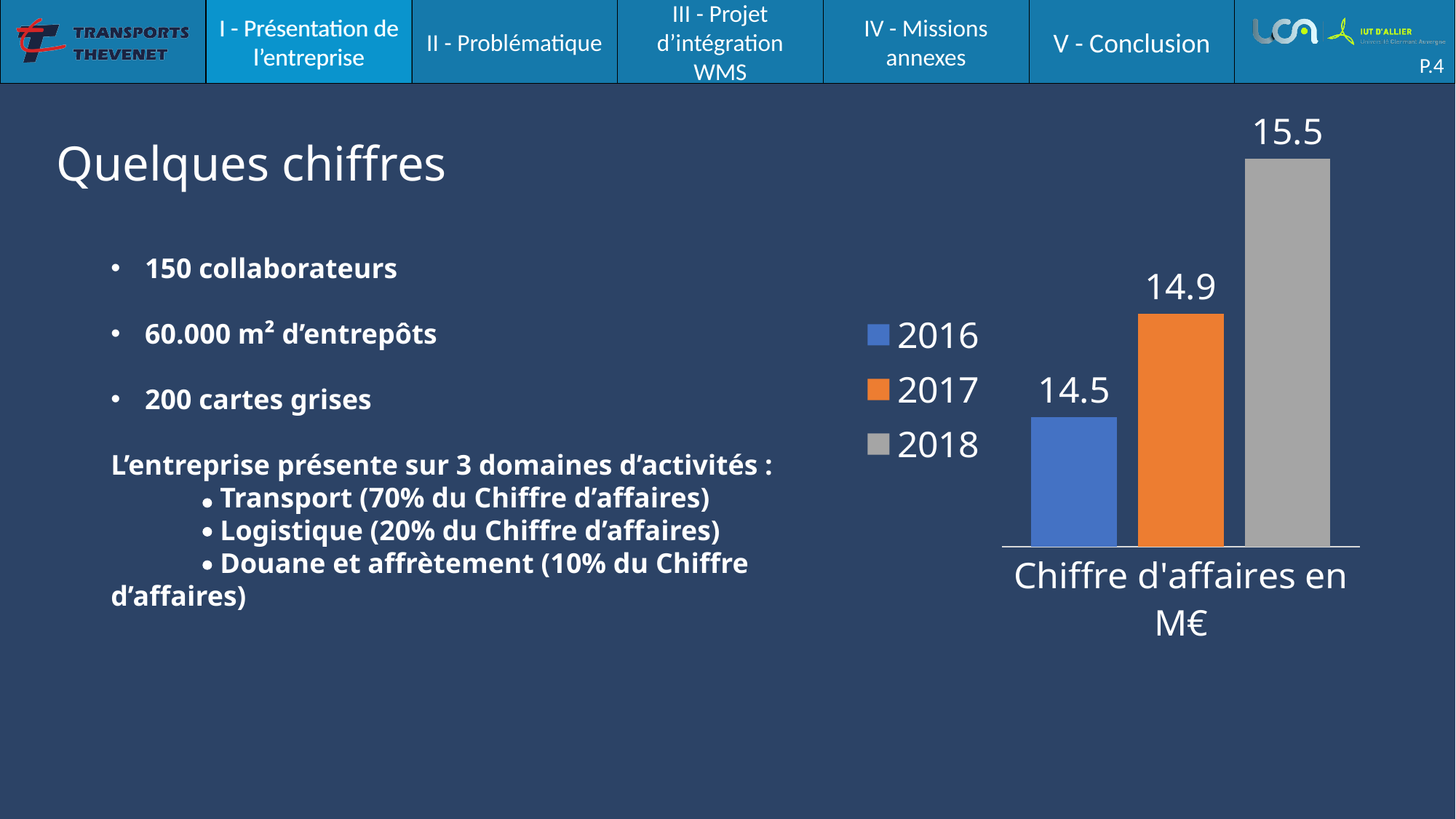
What is the difference between the 2018 and 2016 values? 1.0 What is the difference between the 2017 and 2016 values? 0.4 What kind of chart is shown on the slide? Bar chart What is the value for 2017 in the chart? 14.9 What is the value for 2016 in the chart? 14.5 Do the values rise or fall from 2016 to 2018? Rise What is the category label shown below the bars? Chiffre d'affaires en M€ How many series does the legend list? 3 Which year has the highest value in the chart? 2018 Which is larger, the value for 2017 or the value for 2018? 2018 What is the value for 2018 in the chart? 15.5 Which year has the lowest value in the chart? 2016